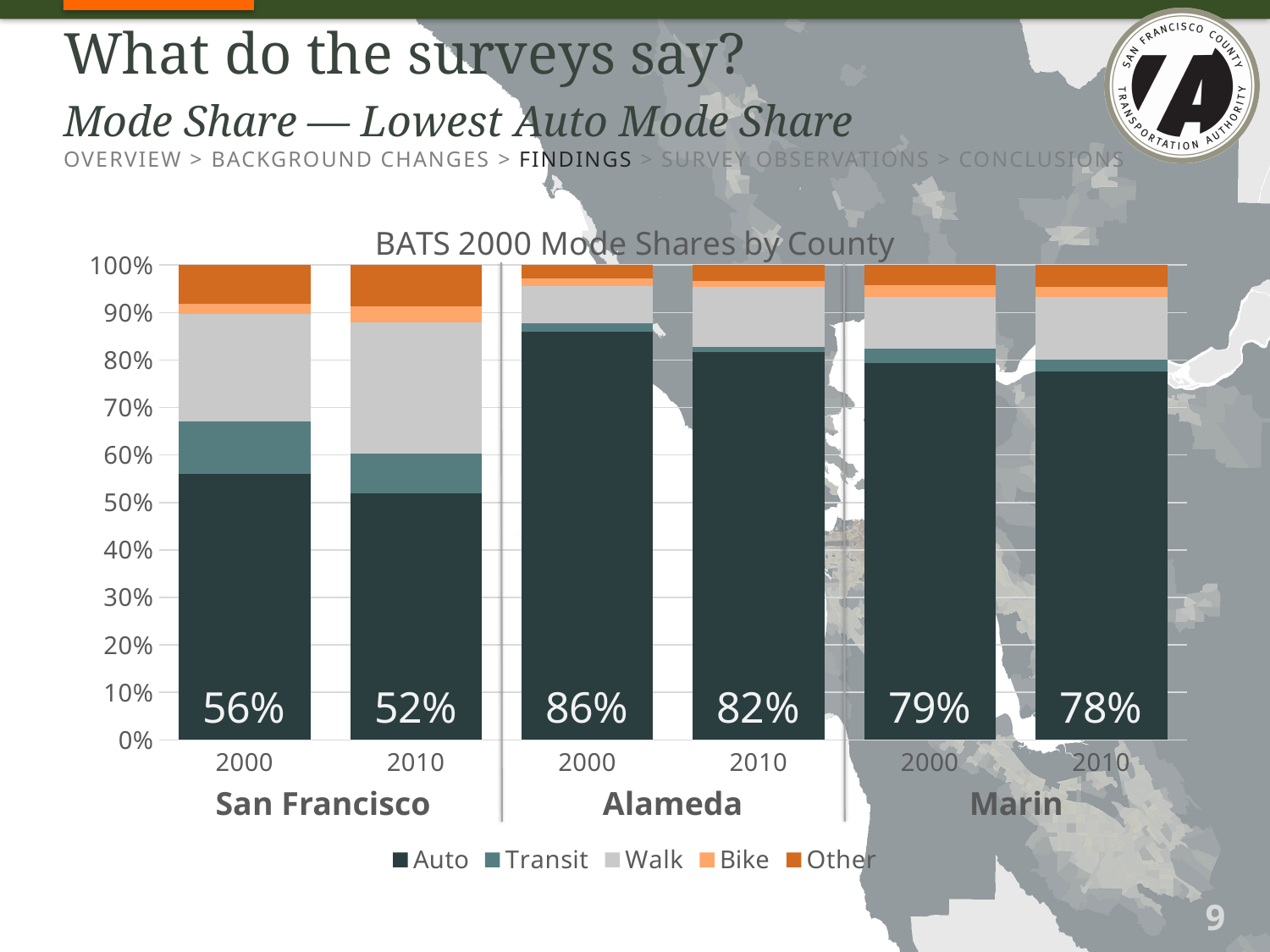
Is the combined Auto and Transit share for San Francisco in 2000 greater or less than 60%? greater Which county and year has the highest Auto mode share? Alameda 2000 What is the Auto mode share for San Francisco in 2000? 56% What kind of chart is shown on the slide? Stacked bar chart What is the Auto mode share for Alameda in 2010? 82% Does the Auto mode share rise or fall from 2000 to 2010 in each county? Fall How many bars are plotted in the chart? 6 By how many percentage points did San Francisco's Auto mode share fall from 2000 to 2010? 4 percentage points How many series does the legend list? 5 Which county and year has the lowest Auto mode share? San Francisco 2010 What is the Auto mode share for Marin in 2010? 78% Which is larger, the Auto mode share for Marin in 2000 or for Alameda in 2010? Alameda in 2010